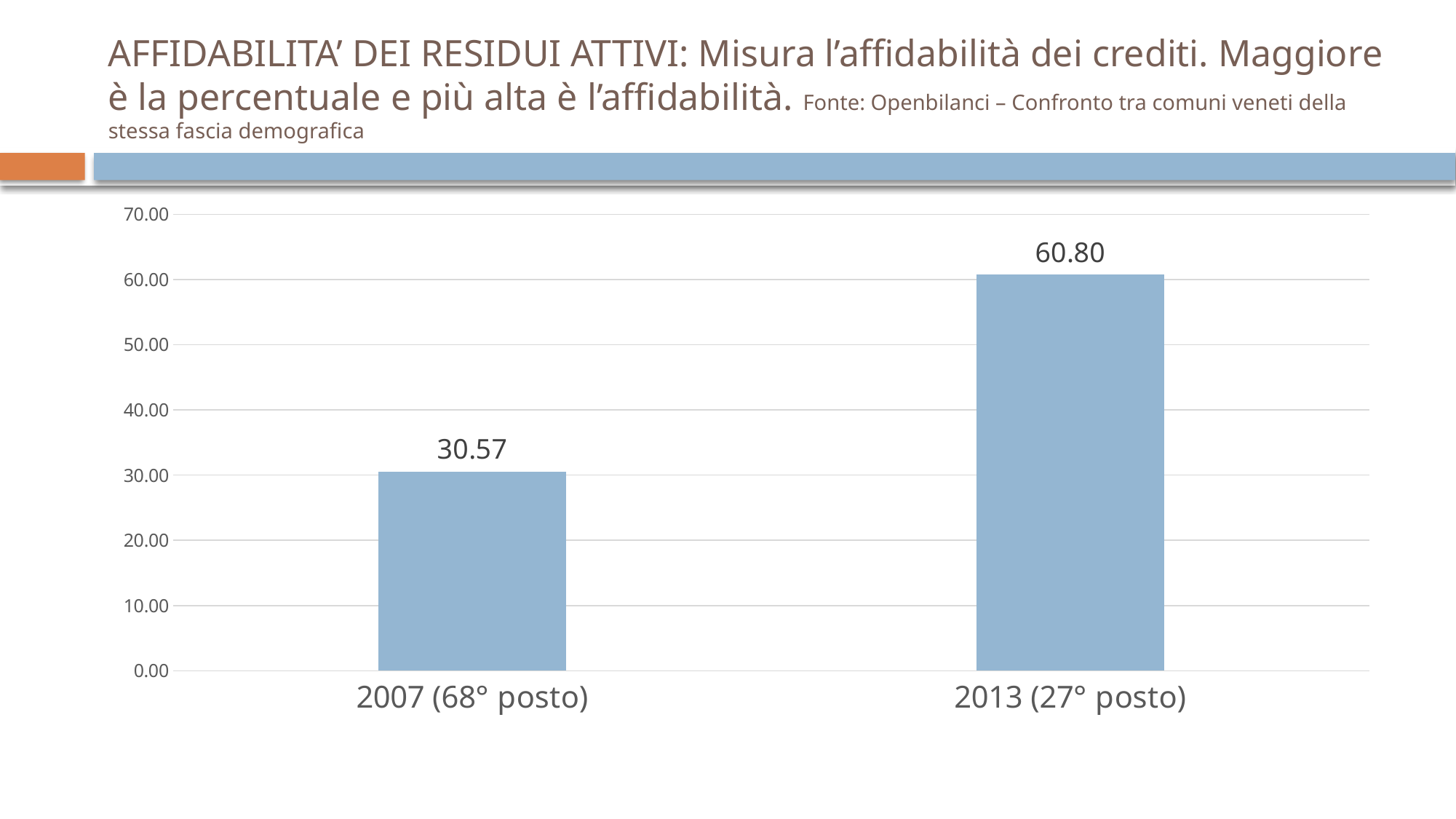
Is the value for 2007 (68° posto) greater or less than 40.00? less How many categories are shown on the chart? 2 What kind of chart is shown on the slide? bar chart Do the values rise or fall from 2007 to 2013? rise What is the difference between the values for 2013 (27° posto) and 2007 (68° posto)? 30.23 What is the value for 2013 (27° posto)? 60.80 Is the value for 2013 (27° posto) greater or less than 50.00? greater Which category has the lowest value? 2007 (68° posto) Which category has the highest value? 2013 (27° posto) Which is larger, the value for 2007 (68° posto) or the value for 2013 (27° posto)? 2013 (27° posto) What is the highest value shown on the vertical axis? 70.00 What is the value for 2007 (68° posto)? 30.57